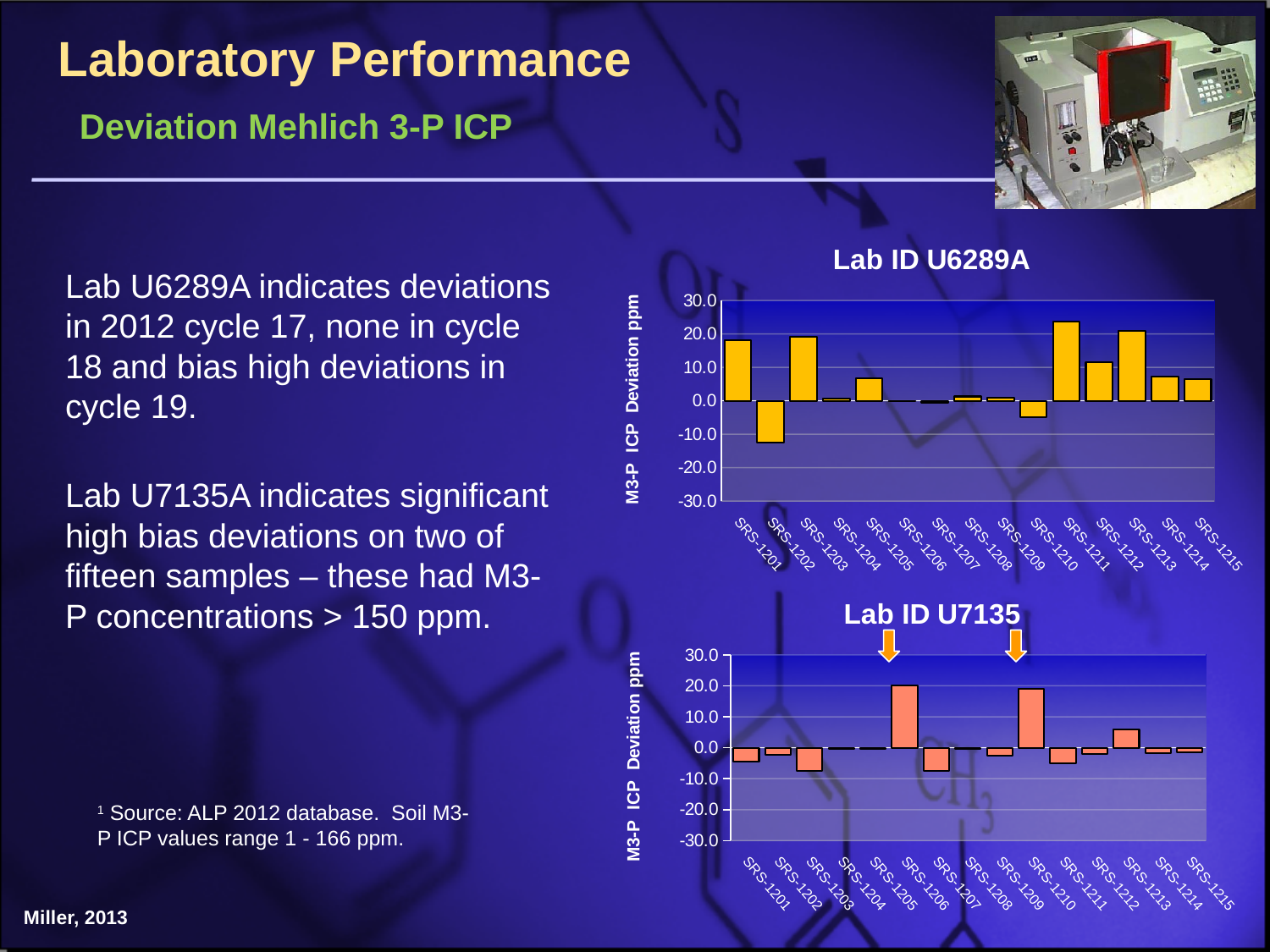
What is the y-axis title on the "Lab ID U7135" chart? M3-P ICP Deviation ppm On the "Lab ID U7135" chart, is the value for SRS-1205 greater or less than 10.0? less On the "Lab ID U6289A" chart, which is larger, the value for SRS-1201 or SRS-1202? SRS-1201 On the "Lab ID U6289A" chart, which sample has the highest deviation? SRS-1211 On the "Lab ID U7135" chart, which two samples are marked with arrows above the bars? SRS-1206 and SRS-1210 On the "Lab ID U6289A" chart, is the value for SRS-1202 greater or less than 0.0? less On the "Lab ID U7135" chart, is the value for SRS-1206 greater or less than 0.0? greater On the "Lab ID U6289A" chart, which sample has the lowest deviation? SRS-1202 How many samples (categories) are plotted on the "Lab ID U7135" chart? 15 What kind of chart is the "Lab ID U6289A" chart? bar chart